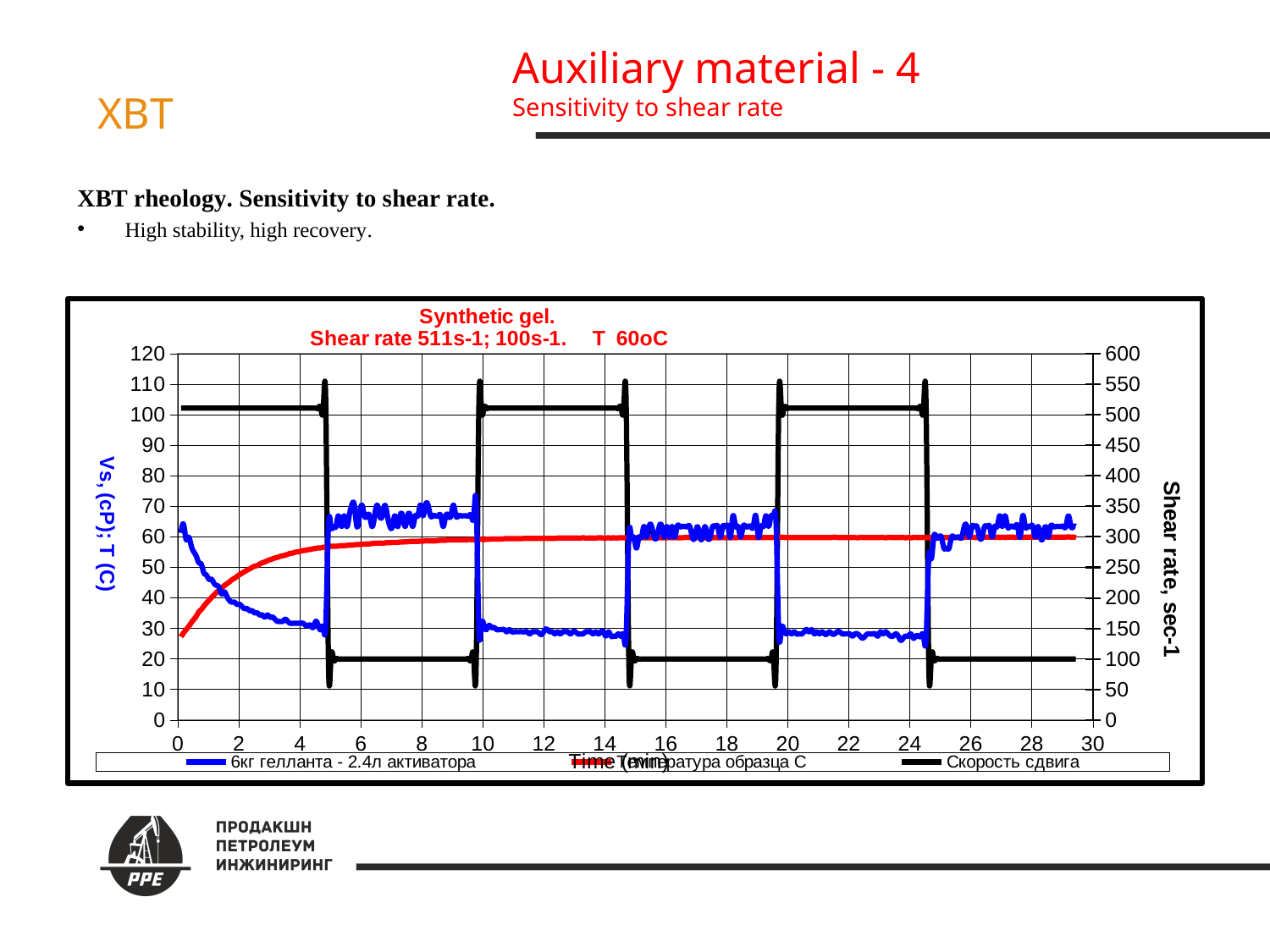
Is the value of the red line (Температура образца C) at time 0 greater or less than 40 on the left axis? less Does the red line (Температура образца C) rise or fall over the first 10 minutes? rise What kind of chart is shown on the slide? line chart Does the blue line (6кг гелланта - 2.4л активатора) rise or fall between 0 and 4 minutes? fall Is the value of the black line (Скорость сдвига) between 1 and 4 minutes greater or less than 400 on the right axis? greater Is the value of the blue line (6кг гелланта - 2.4л активатора) at 7 minutes greater or less than 50 on the left axis? greater How many series does the chart legend list? 3 What is the title of the chart? Synthetic gel. Shear rate 511s-1; 100s-1. T 60oC What is the label of the right-hand vertical axis of the chart? Shear rate, sec-1